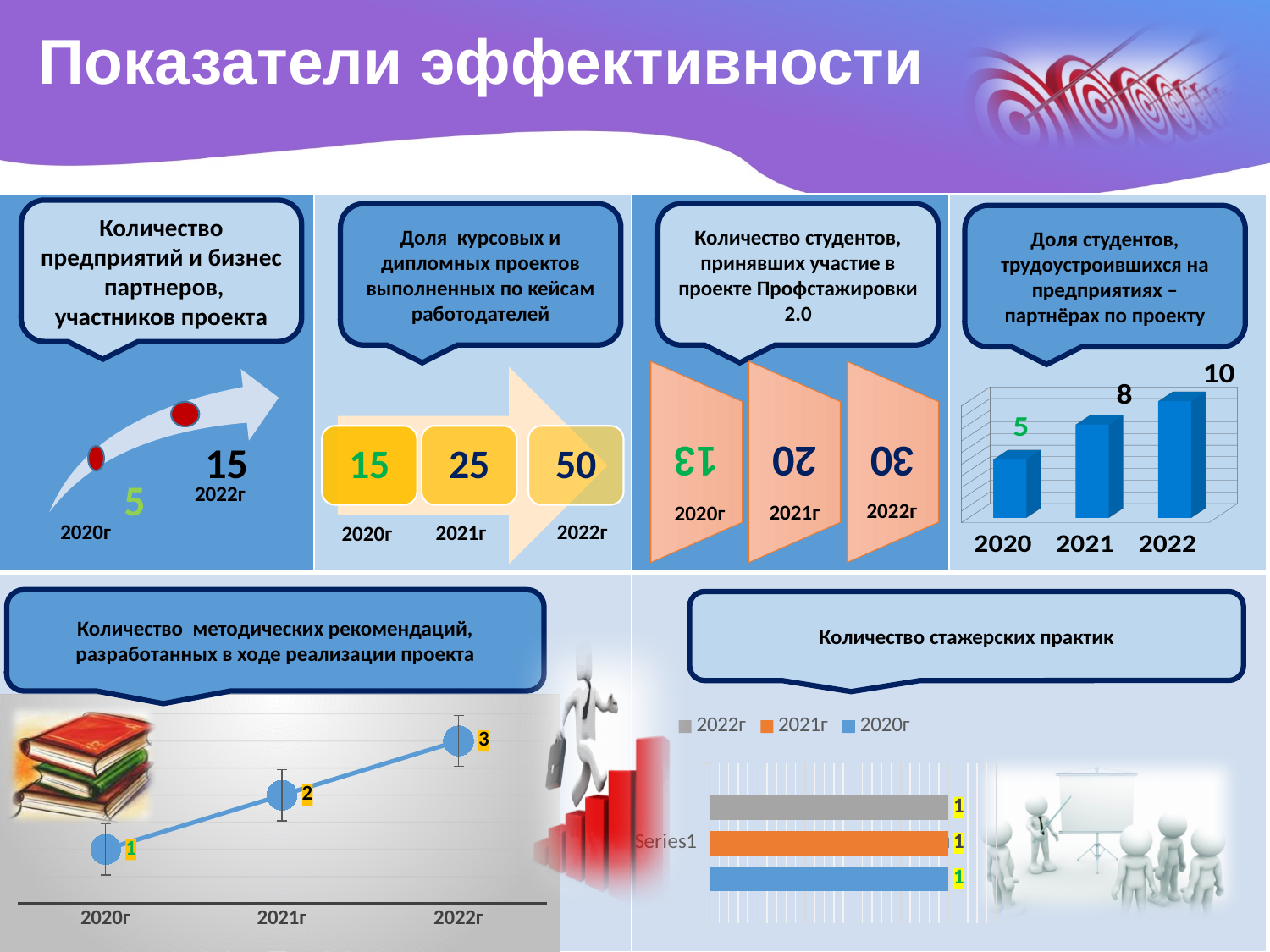
What kind of chart is 'Количество методических рекомендаций, разработанных в ходе реализации проекта'? line chart In the chart 'Доля студентов, трудоустроившихся на предприятиях – партнёрах по проекту', do the values rise or fall from 2020 to 2022? rise In the chart 'Количество стажерских практик', what is the value of the 2021г bar? 1 In the chart 'Количество методических рекомендаций, разработанных в ходе реализации проекта', what is the value for 2021г? 2 In the chart 'Количество методических рекомендаций, разработанных в ходе реализации проекта', which is larger, the value for 2022г or 2020г? 2022г In the chart 'Доля студентов, трудоустроившихся на предприятиях – партнёрах по проекту', what is the difference between the values for 2022 and 2020? 5 In the chart 'Доля студентов, трудоустроившихся на предприятиях – партнёрах по проекту', which year has the highest value? 2022 In the chart 'Доля студентов, трудоустроившихся на предприятиях – партнёрах по проекту', what is the value for 2021? 8 How many series does the legend of the chart 'Количество стажерских практик' list? 3 What kind of chart is 'Доля студентов, трудоустроившихся на предприятиях – партнёрах по проекту'? bar chart In the chart 'Доля студентов, трудоустроившихся на предприятиях – партнёрах по проекту', which year has the lowest value? 2020 In the chart 'Количество методических рекомендаций, разработанных в ходе реализации проекта', how many years are plotted? 3